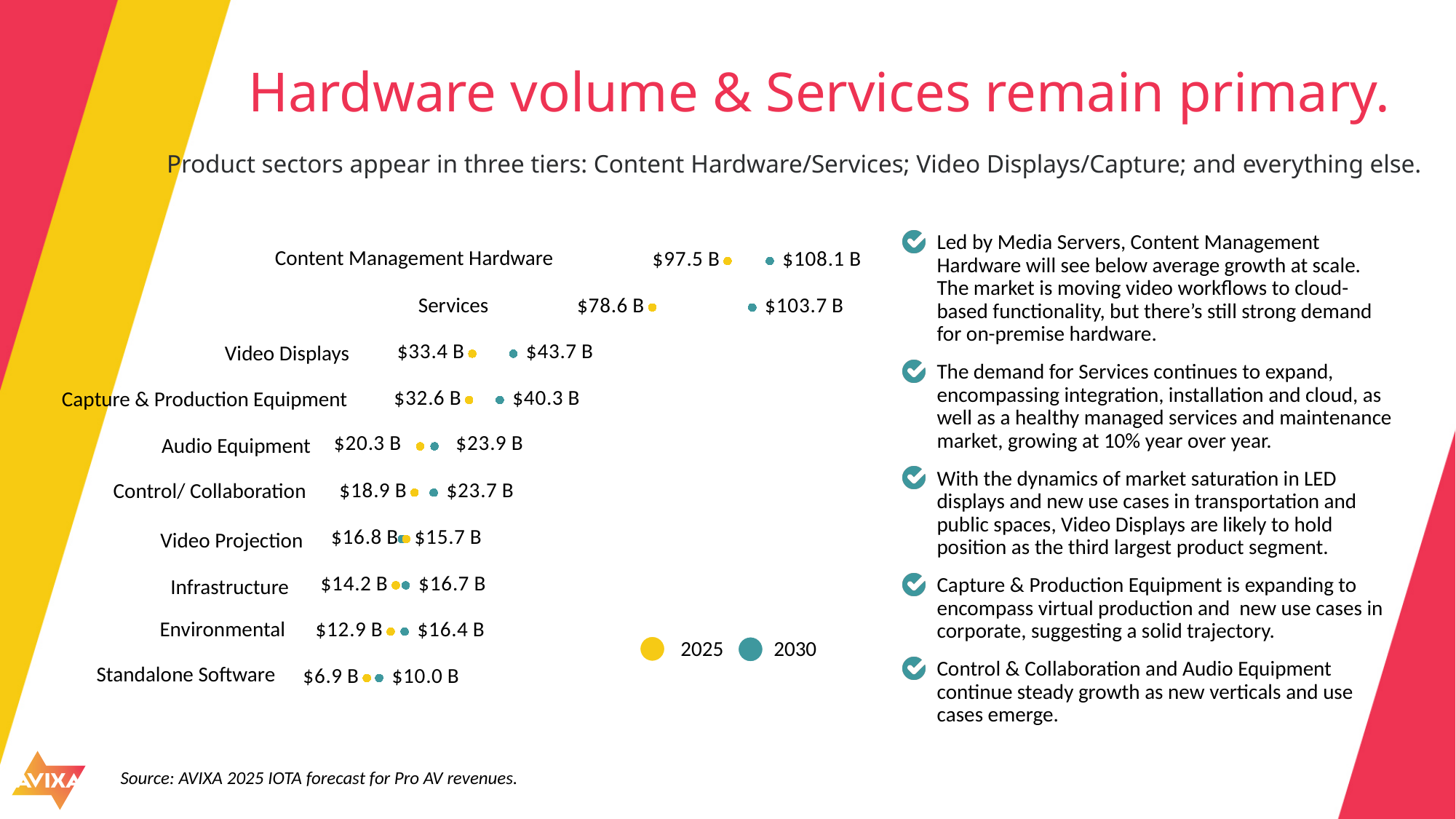
Which is larger for Video Projection, the 2025 value or the 2030 value? 2025 What is the 2030 value for Services? $103.7 B What is the 2030 value for Capture & Production Equipment? $40.3 B What is the 2025 value for Video Displays? $33.4 B What kind of chart is used to show the product sector values? Dot plot What is the difference between the 2030 and 2025 values for Services? $25.1 B Which product sector has the lowest 2025 value? Standalone Software How many product sectors are plotted in the chart? 10 How many series does the chart legend list? 2 Which product sector has the highest 2030 value? Content Management Hardware What is the difference between the 2030 and 2025 values for Standalone Software? $3.1 B Which two years are shown in the chart legend? 2025 and 2030